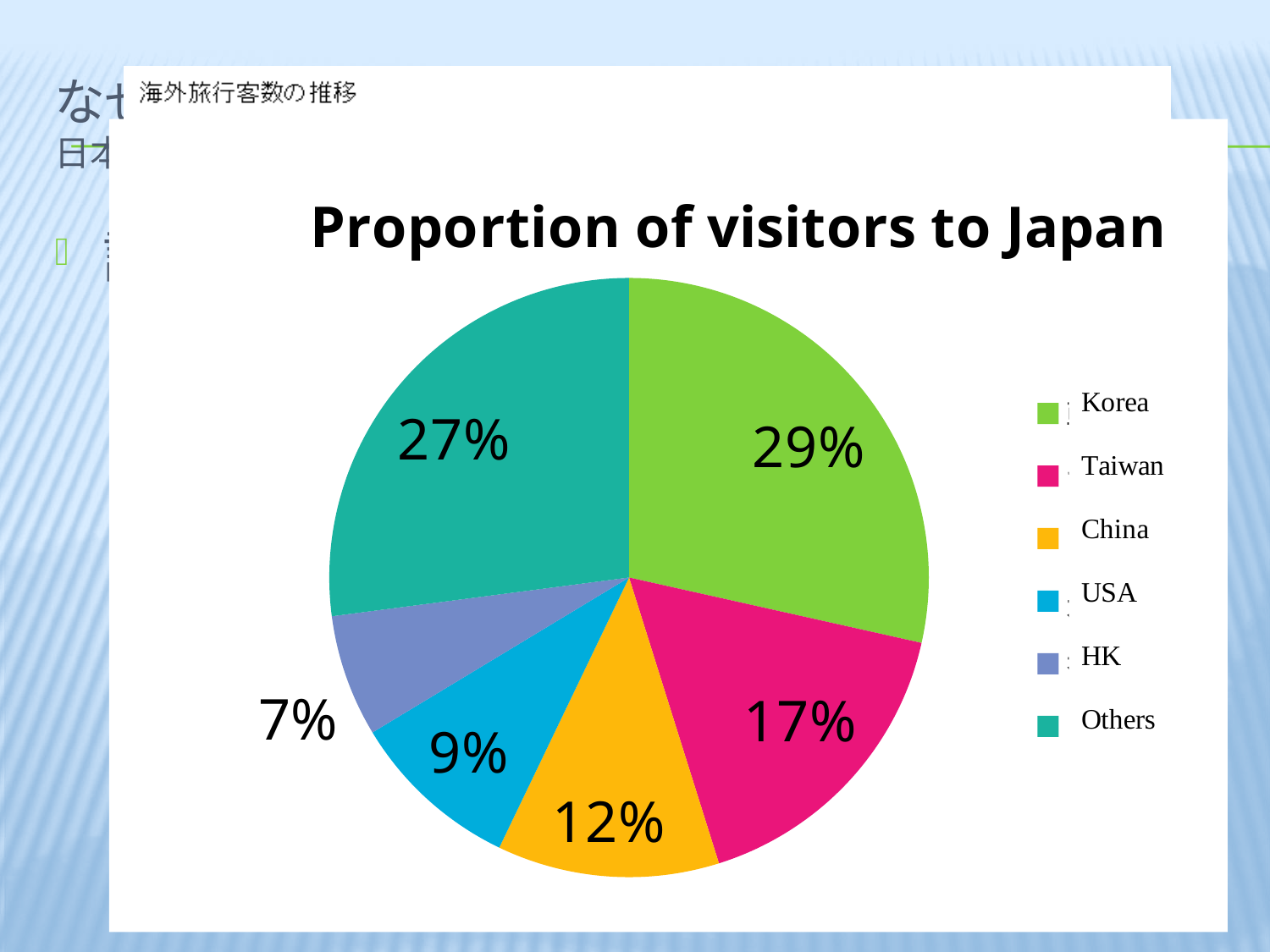
What kind of chart is shown on the slide? pie chart Which category has the largest share of visitors to Japan? Korea What share of visitors to Japan comes from Korea? 29% What share of visitors to Japan comes from Taiwan? 17% What is the title of the chart? Proportion of visitors to Japan Which category has the smallest share of visitors to Japan? HK What share of visitors to Japan comes from the USA? 9% What share of visitors to Japan comes from HK? 7% Which has a larger share of visitors, China or the USA? China What share of visitors to Japan comes from China? 12% What is the difference in percentage points between the Korea and Taiwan shares? 12 How many categories does the legend list? 6